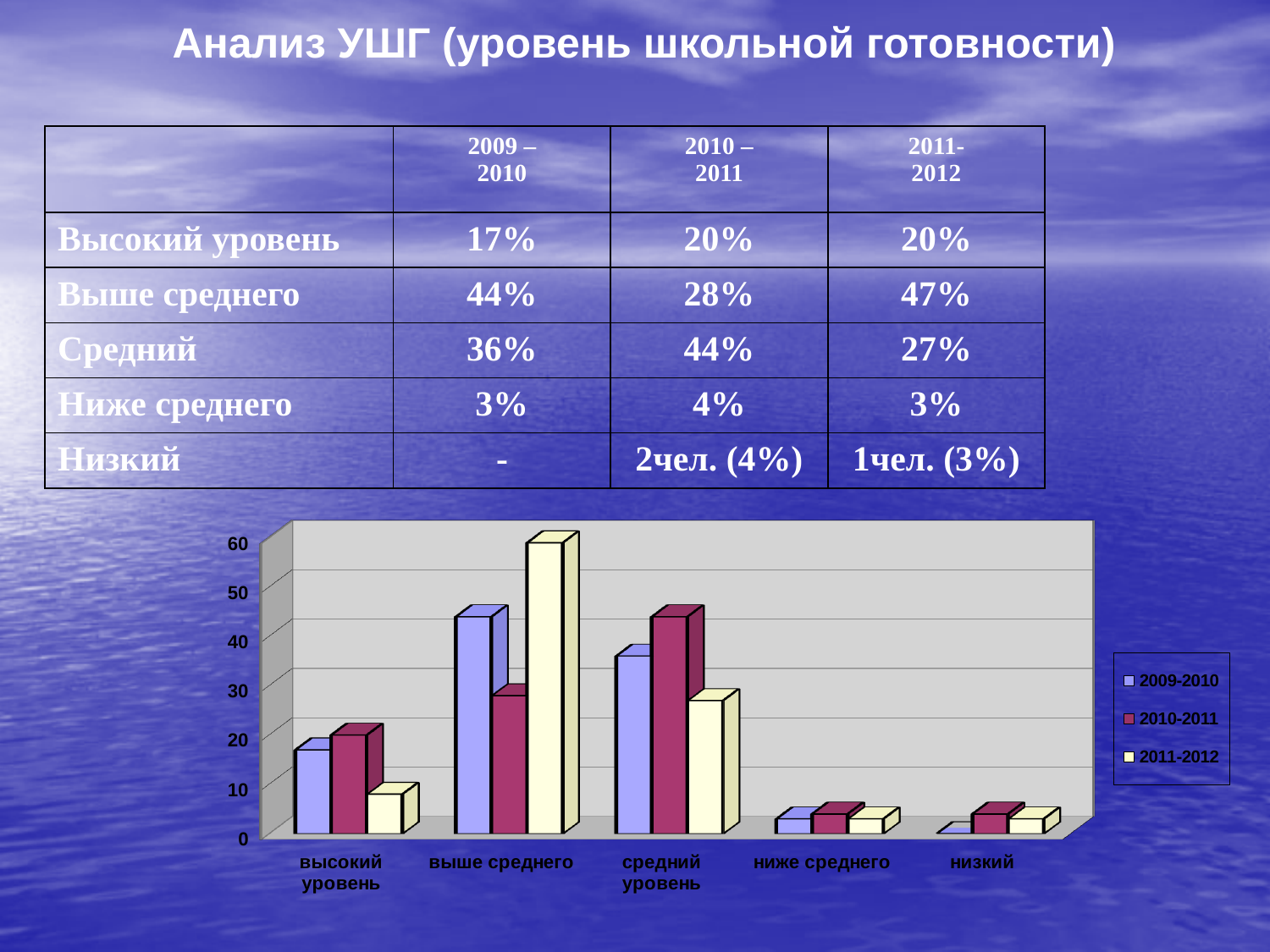
For высокий уровень, which series has the taller bar: 2009-2010 or 2011-2012? 2009-2010 What kind of chart is shown on the slide? bar chart Is the 2011-2012 bar for выше среднего greater or less than 50? greater How many series does the chart legend list? 3 Is the 2010-2011 bar for выше среднего greater or less than 40? less Is the 2011-2012 bar for средний уровень greater or less than 20? greater How many categories are shown along the x axis of the chart? 5 What are the three entries in the chart legend? 2009-2010, 2010-2011, 2011-2012 Which category has the lowest bar for the 2009-2010 series? низкий Which category has the tallest bar for the 2011-2012 series? выше среднего For средний уровень, which series has the taller bar: 2010-2011 or 2011-2012? 2010-2011